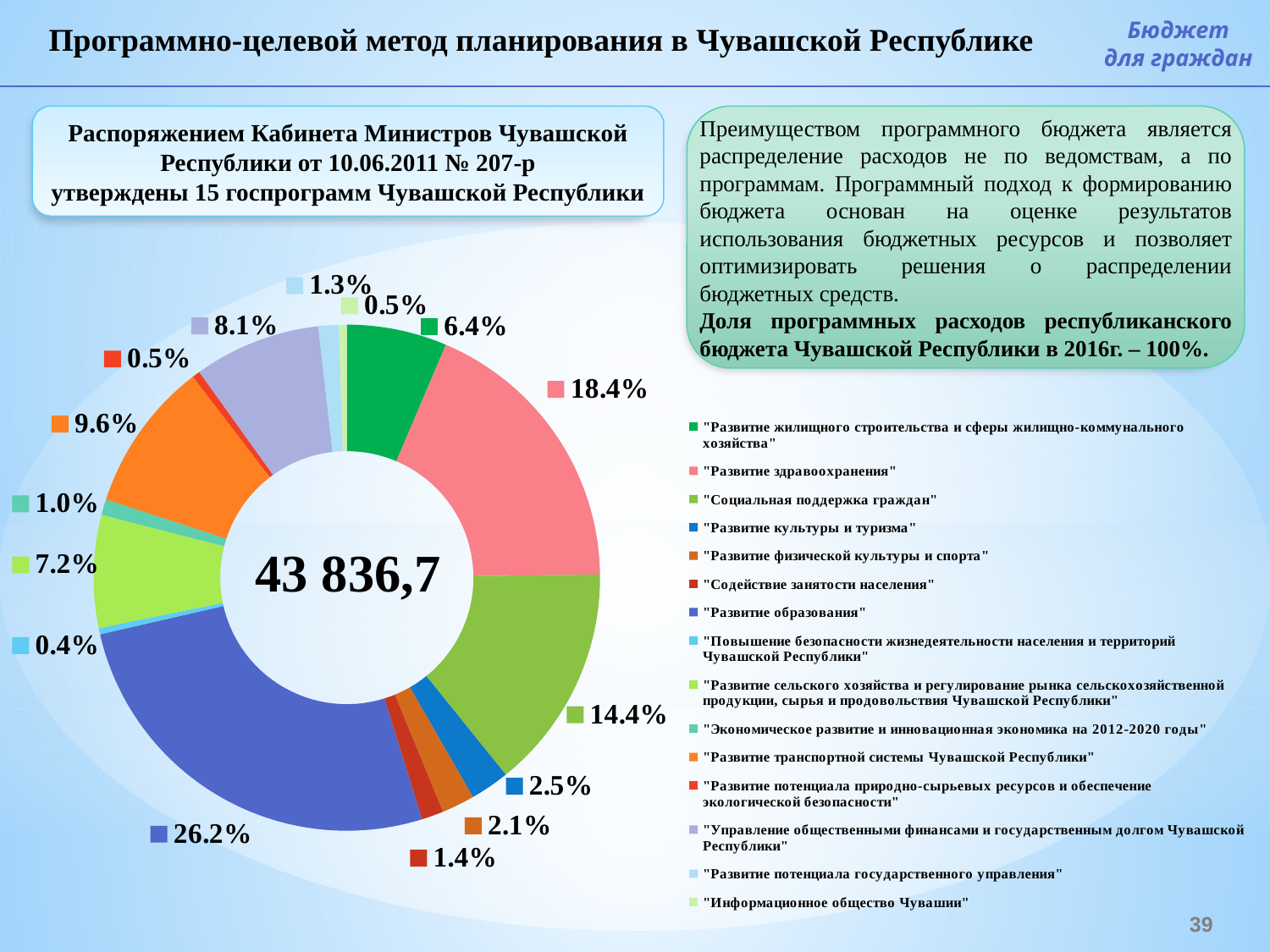
How many entries does the chart legend list? 15 What is the share of "Развитие образования"? 26.2% What is the share of "Развитие здравоохранения"? 18.4% What is the share of "Развитие транспортной системы Чувашской Республики"? 9.6% What is the share of "Развитие культуры и туризма"? 2.5% Which programme has the largest share in the chart? "Развитие образования" What is the difference in percentage points between "Развитие здравоохранения" and "Социальная поддержка граждан"? 4.0 What kind of chart is shown on the slide? Doughnut (pie) chart Which has a larger share: "Развитие сельского хозяйства и регулирование рынка сельскохозяйственной продукции, сырья и продовольствия Чувашской Республики" or "Управление общественными финансами и государственным долгом Чувашской Республики"? "Управление общественными финансами и государственным долгом Чувашской Республики" How many slices does the doughnut chart have? 15 Which programme has the smallest share in the chart? "Повышение безопасности жизнедеятельности населения и территорий Чувашской Республики" What value is printed in the centre of the doughnut chart? 43 836,7